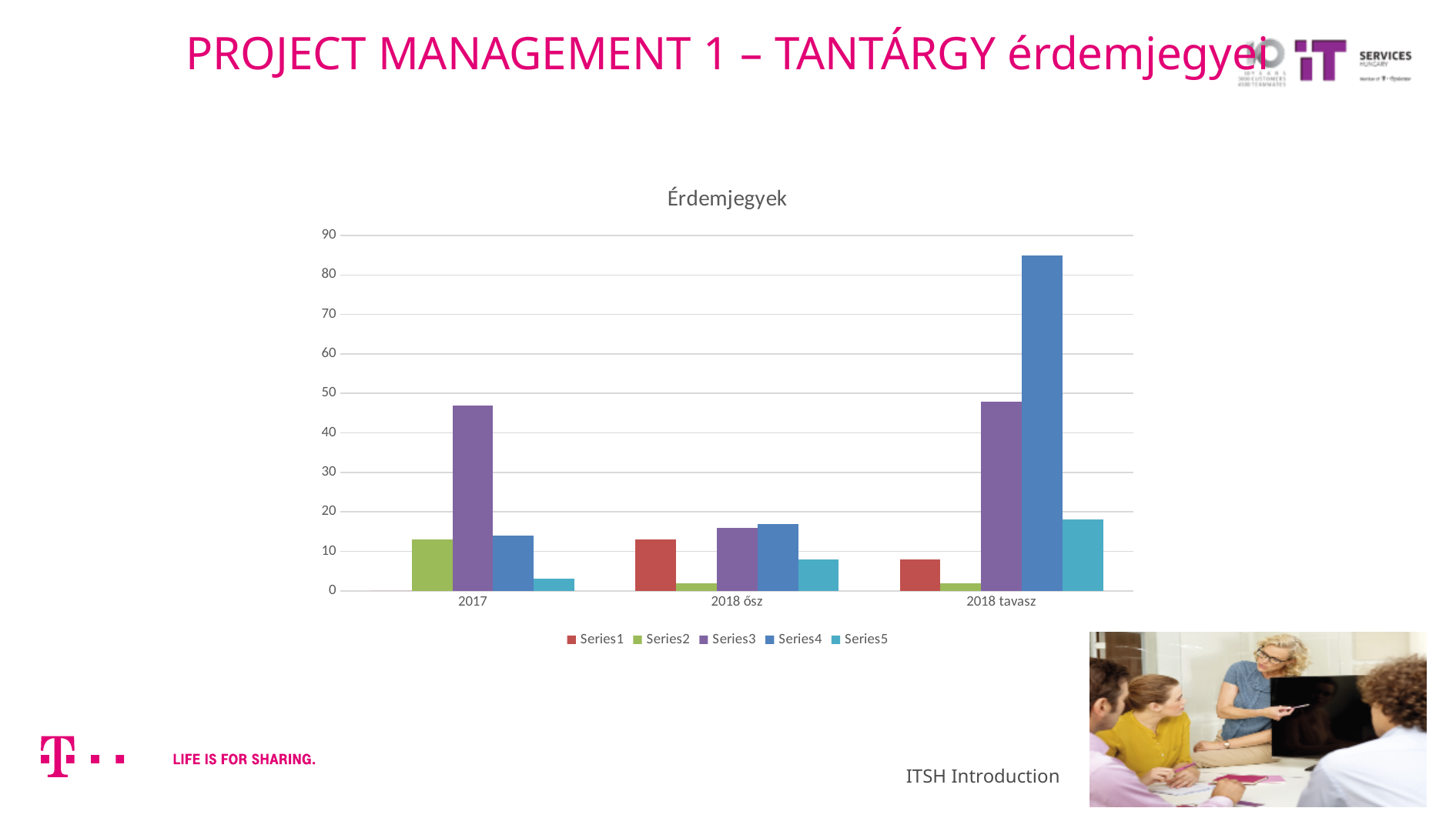
Which series has the smallest bar in 2018 tavasz? Series2 Is the value for Series4 in 2018 tavasz greater or less than 80? greater Is the value for Series1 in 2018 ősz greater or less than 10? greater Is the value for Series3 in 2017 greater or less than 40? greater Which is larger: Series3 in 2017 or Series3 in 2018 ősz? Series3 in 2017 What is the title of the chart? Érdemjegyek What kind of chart is shown on the slide? bar chart How many series does the legend list? 5 Which category contains the tallest bar in the chart? 2018 tavasz How many categories are shown on the x axis? 3 In 2018 tavasz, which is larger: Series3 or Series4? Series4